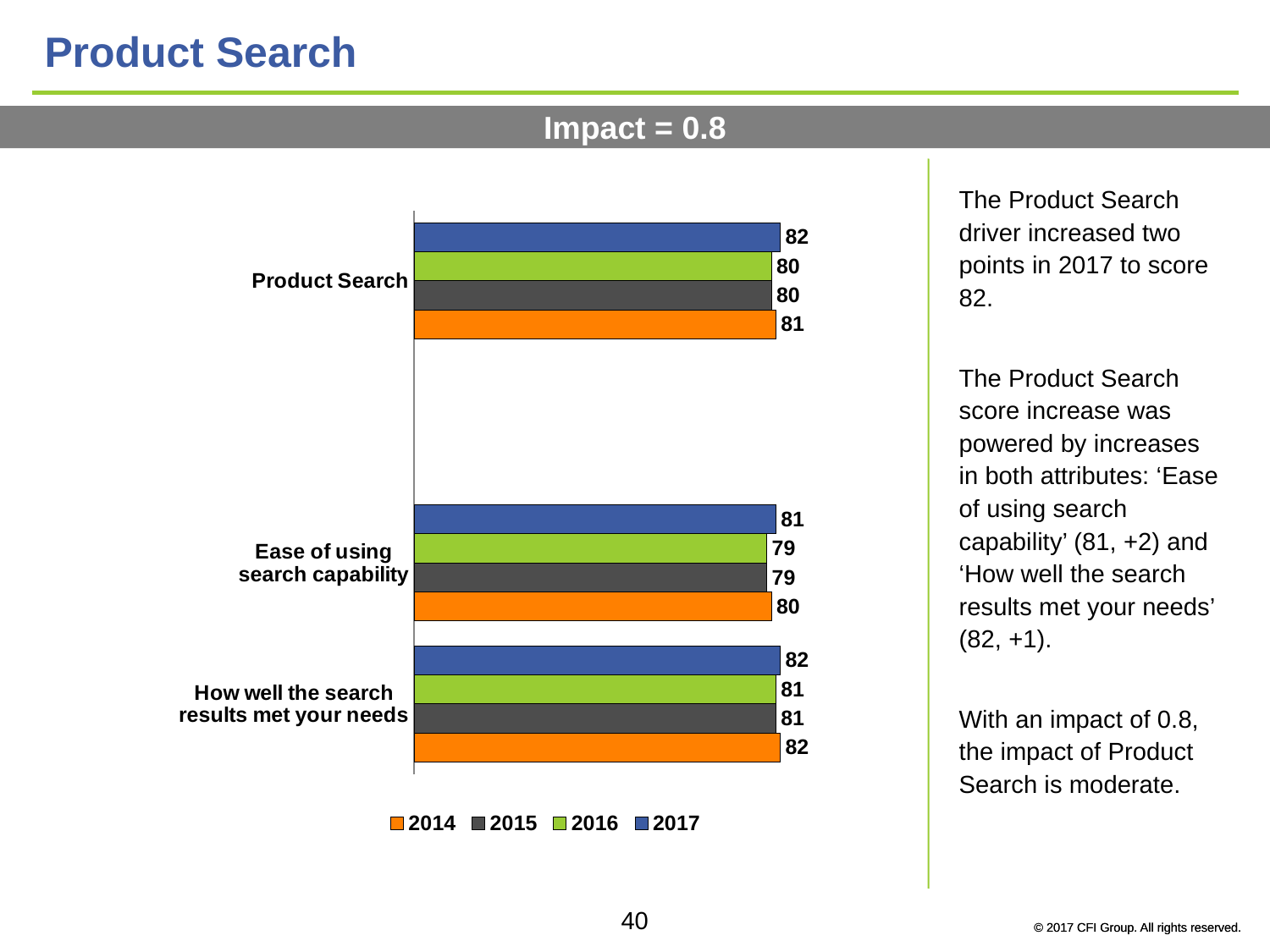
How many categories are shown on the chart? 3 What is the 2015 value for Product Search? 80 Which is larger for Ease of using search capability, the 2017 value or the 2016 value? 2017 Which category has the lowest 2017 value? Ease of using search capability What is the difference between the 2017 and 2016 values for Product Search? 2 What kind of chart is shown on the slide? Bar chart What is the difference between the 2017 and 2015 values for Ease of using search capability? 2 What is the 2017 value for Product Search? 82 What is the 2014 value for Ease of using search capability? 80 Which series is shown in orange in the legend? 2014 What is the 2016 value for How well the search results met your needs? 81 How many series does the legend list? 4